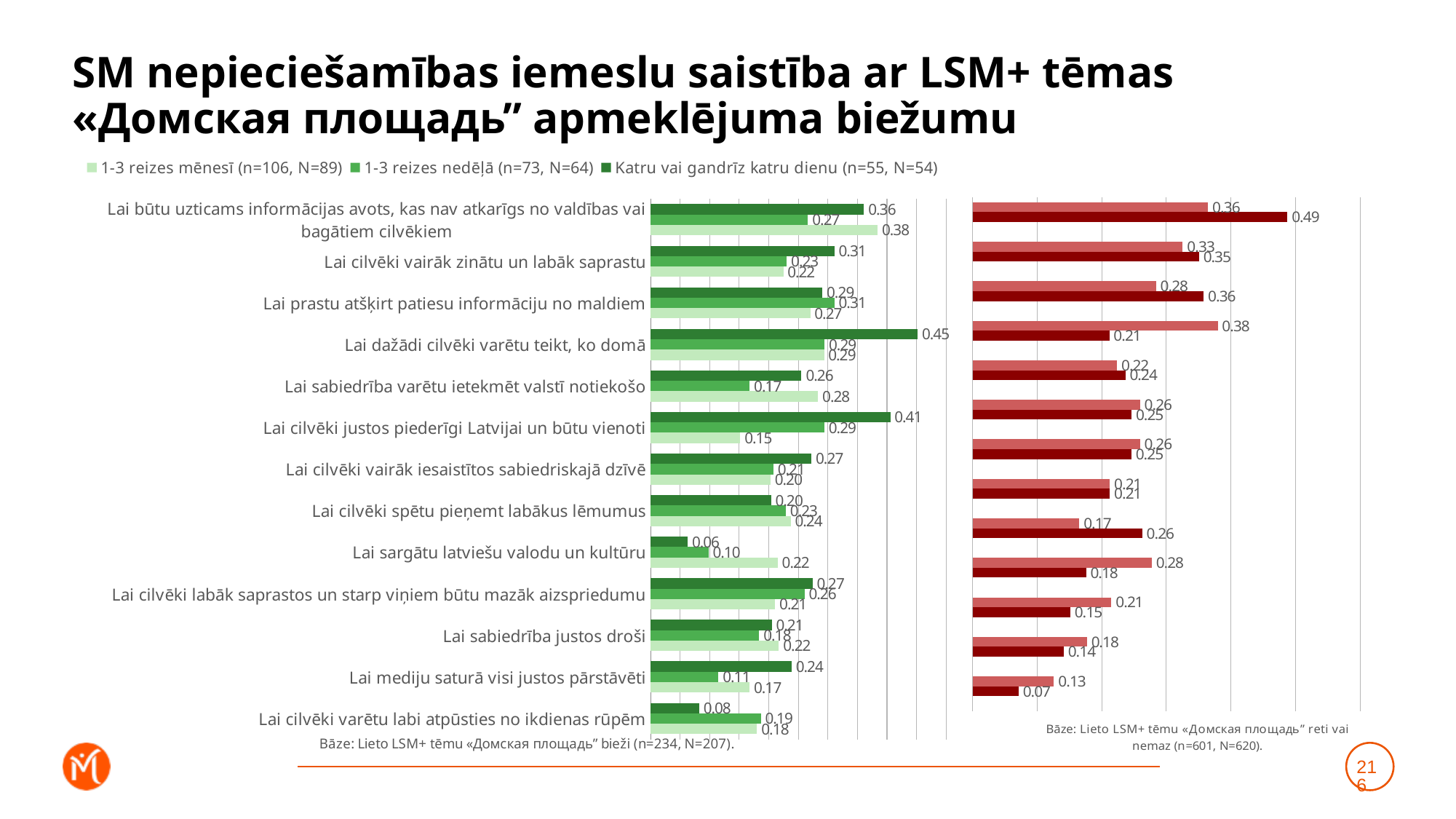
In the right (red) chart, what is the value of the lighter red bar for 'Lai cilvēki varētu labi atpūsties no ikdienas rūpēm'? 0.13 In the left (green) chart, which category has the lowest value for 'Katru vai gandrīz katru dienu'? Lai sargātu latviešu valodu un kultūru In the right (red) chart, what is the value of the darker red bar for 'Lai būtu uzticams informācijas avots, kas nav atkarīgs no valdības vai bagātiem cilvēkiem'? 0.49 What is the first legend entry of the left (green) chart? 1-3 reizes mēnesī (n=106, N=89) In the left (green) chart, what is the difference between the 'Katru vai gandrīz katru dienu' and '1-3 reizes mēnesī' values for 'Lai cilvēki justos piederīgi Latvijai un būtu vienoti'? 0.26 In the left (green) chart, what is the value for '1-3 reizes mēnesī' for 'Lai cilvēki justos piederīgi Latvijai un būtu vienoti'? 0.15 What kind of chart is shown on the left side of the slide? bar chart In the left (green) chart, for 'Lai sargātu latviešu valodu un kultūru', which series has the larger value: '1-3 reizes mēnesī' or 'Katru vai gandrīz katru dienu'? 1-3 reizes mēnesī How many categories are plotted in the left (green) chart? 13 In the left (green) chart, which category has the highest value for 'Katru vai gandrīz katru dienu'? Lai dažādi cilvēki varētu teikt, ko domā In the left (green) chart, what is the value for 'Katru vai gandrīz katru dienu' for 'Lai dažādi cilvēki varētu teikt, ko domā'? 0.45 How many series does the legend of the left (green) chart list? 3